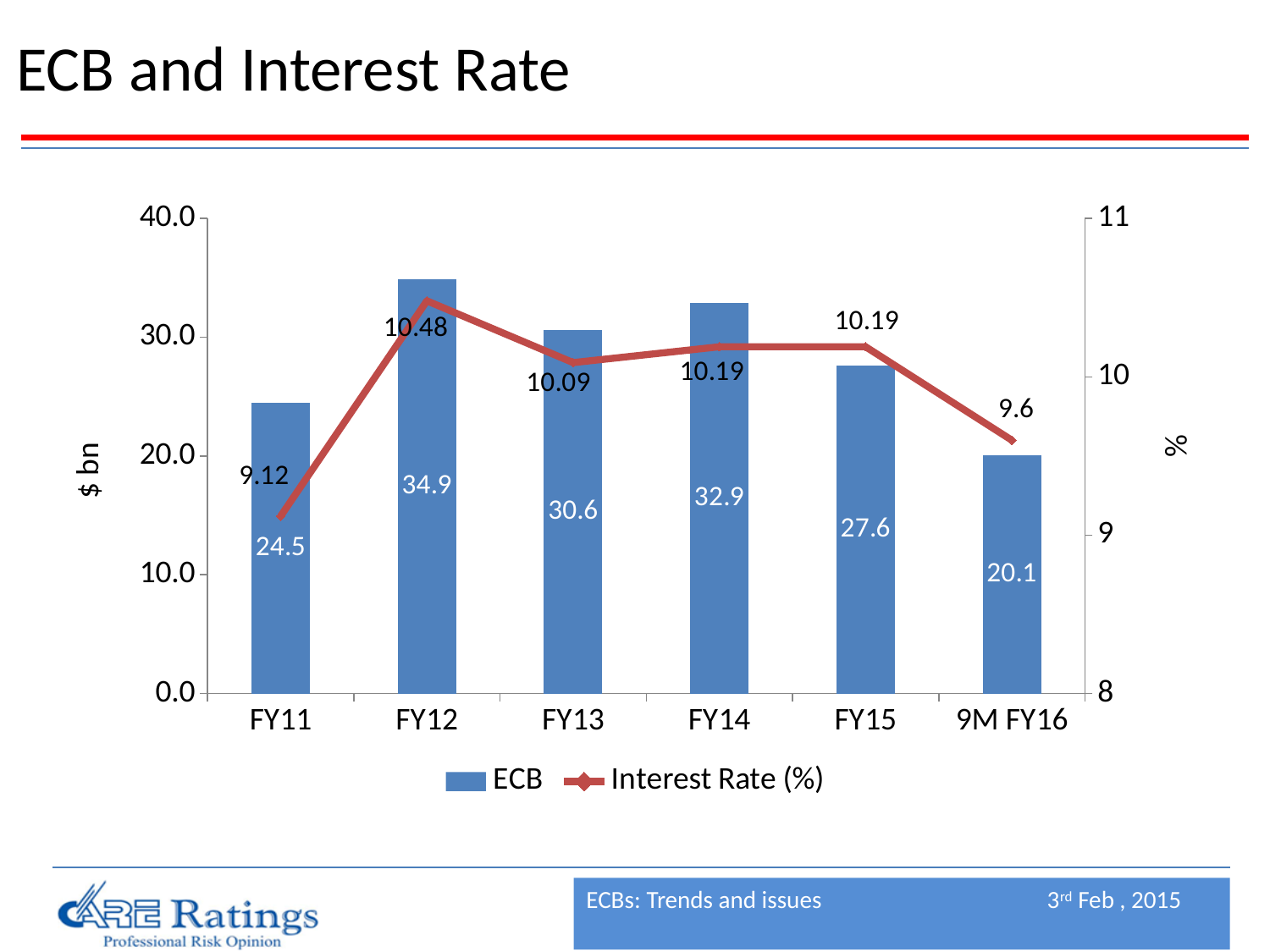
Which period has the highest ECB value? FY12 What is the ECB value for FY12? 34.9 What kind of chart is used for the ECB series? Bar chart What is the difference between the ECB values for FY12 and FY15? 7.3 How many series does the legend list? 2 What is the ECB value for 9M FY16? 20.1 What is the Interest Rate (%) for FY11? 9.12 Which is larger, the ECB value for FY13 or for FY14? FY14 What is the title of the slide? ECB and Interest Rate How many periods are shown on the x axis? 6 Which period has the lowest Interest Rate (%)? FY11 What is the Interest Rate (%) for FY13? 10.09